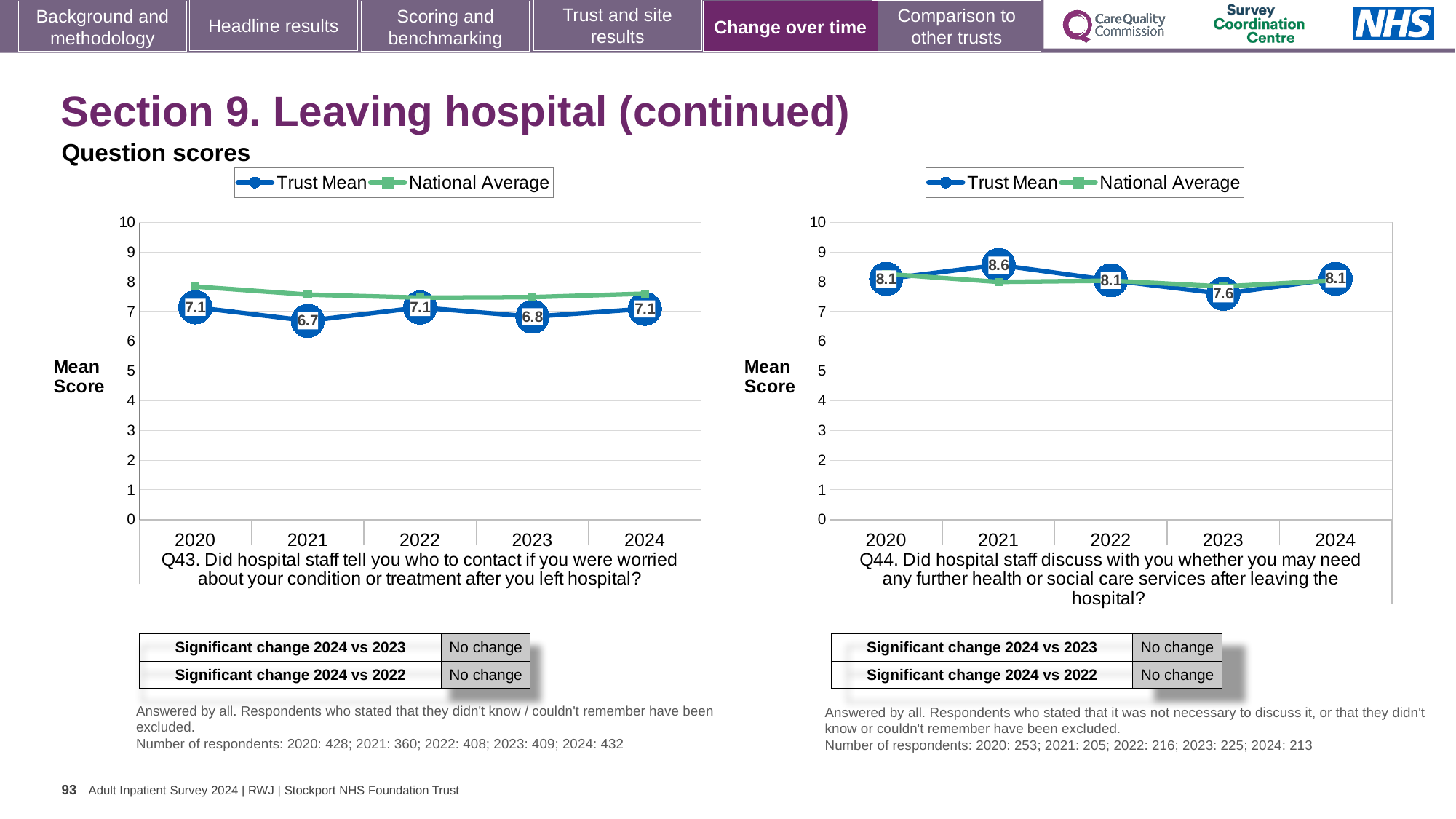
How many series does the legend of the Q43 chart on the left list? 2 In the Q43 chart on the left, what is the Trust Mean score for 2024? 7.1 In the Q44 chart on the right, what is the Trust Mean score for 2021? 8.6 In the Q43 chart on the left, is the National Average for 2020 greater or less than 7? greater How many years are plotted on the x axis of the Q44 chart on the right? 5 In the Q44 chart on the right, which year has the highest Trust Mean score? 2021 In the Q43 chart on the left, is the Trust Mean score for 2020 higher or lower than the National Average for 2020? lower In the Q43 chart on the left, which year has the lowest Trust Mean score? 2021 What type of chart is used for Q44 on the right? Line chart In the Q44 chart on the right, what is the difference between the Trust Mean scores for 2021 and 2023? 1.0 In the Q43 chart on the left, what is the Trust Mean score for 2021? 6.7 In the Q44 chart on the right, what is the Trust Mean score for 2023? 7.6